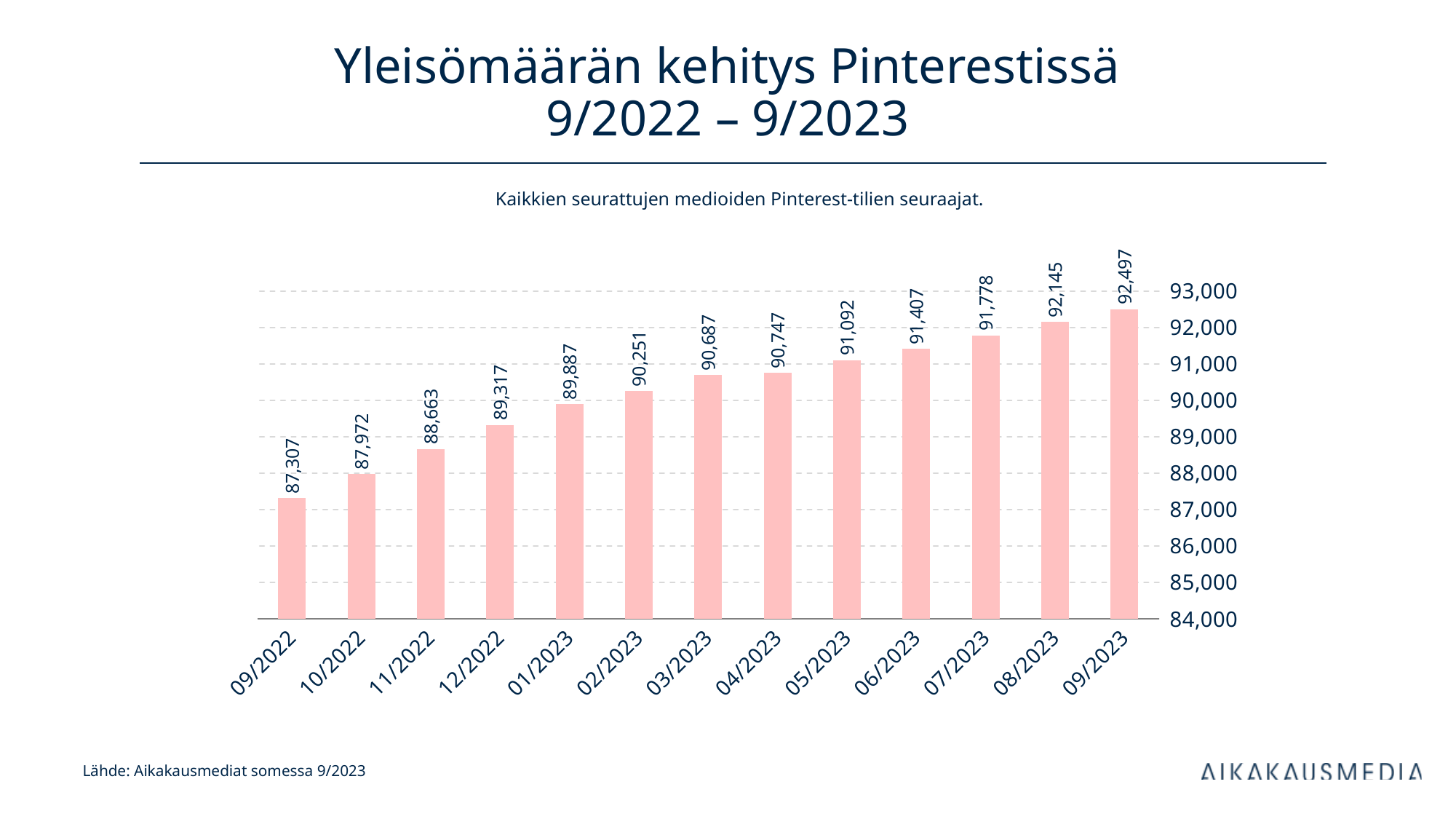
What is the value for 09/2023? 92,497 Which month has the lowest value? 09/2022 What kind of chart is shown on the slide? bar chart Do the values rise or fall from 09/2022 to 09/2023? rise What is the difference between the values for 09/2023 and 09/2022? 5,190 What is the value for 09/2022? 87,307 What is the value for 03/2023? 90,687 Which is larger, the value for 01/2023 or the value for 06/2023? 06/2023 Which month has the highest value? 09/2023 How many months are shown on the x axis? 13 Is the value for 02/2023 greater or less than 90,000? greater What is the difference between the values for 12/2022 and 11/2022? 654